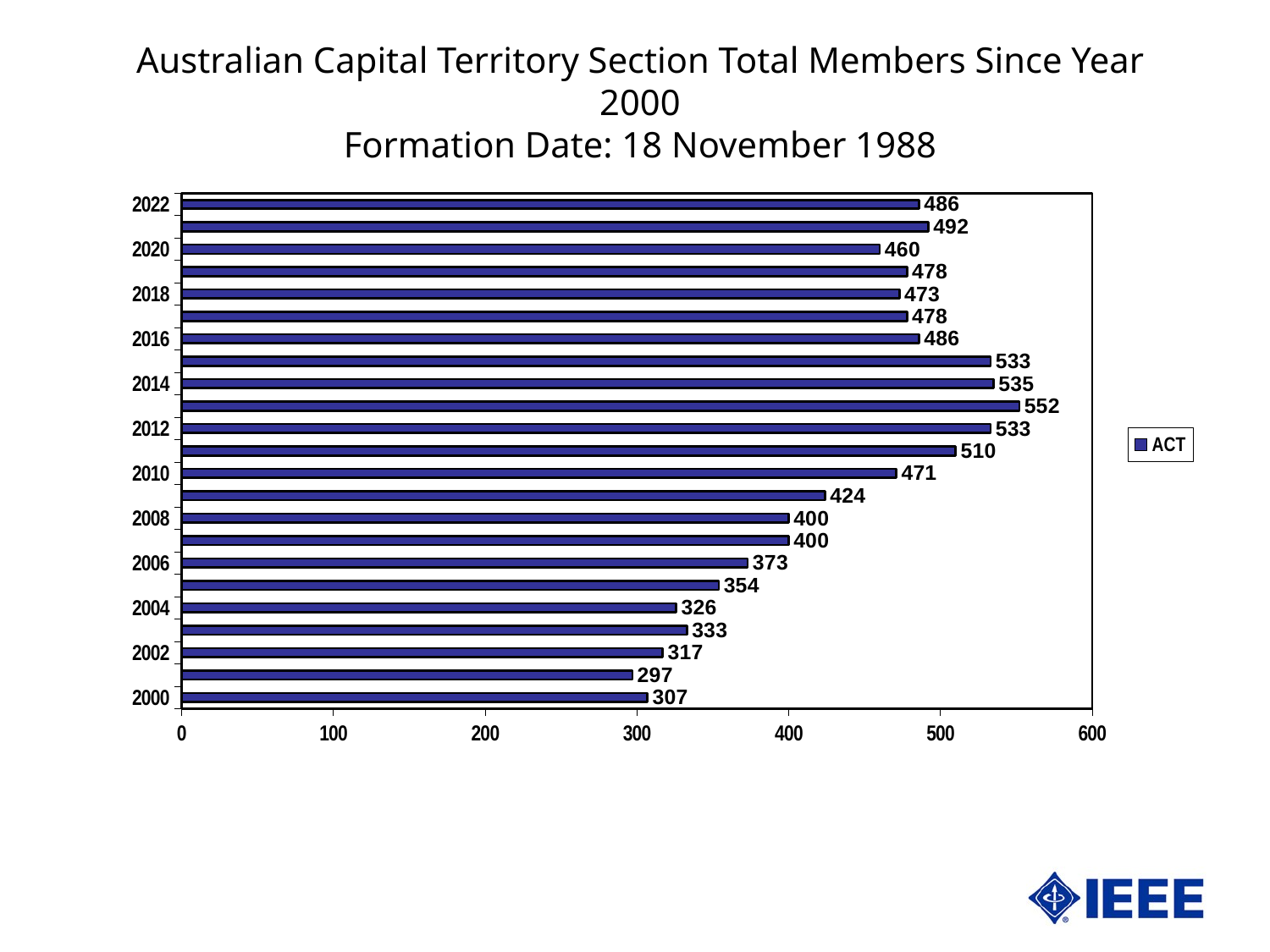
How many series does the legend list? 1 Is the value for 2008 greater or less than 500? less What was the total number of ACT Section members in 2012? 533 How many more members did the ACT Section have in 2022 than in 2000? 179 What is the formation date given in the chart title? 18 November 1988 What is the highest member count shown on the chart? 552 What type of chart is shown on the slide? bar chart What was the total number of ACT Section members in 2020? 460 Which year had more members, 2010 or 2018? 2018 What was the total number of ACT Section members in 2000? 307 What is the lowest member count shown on the chart? 297 What was the total number of ACT Section members in 2022? 486